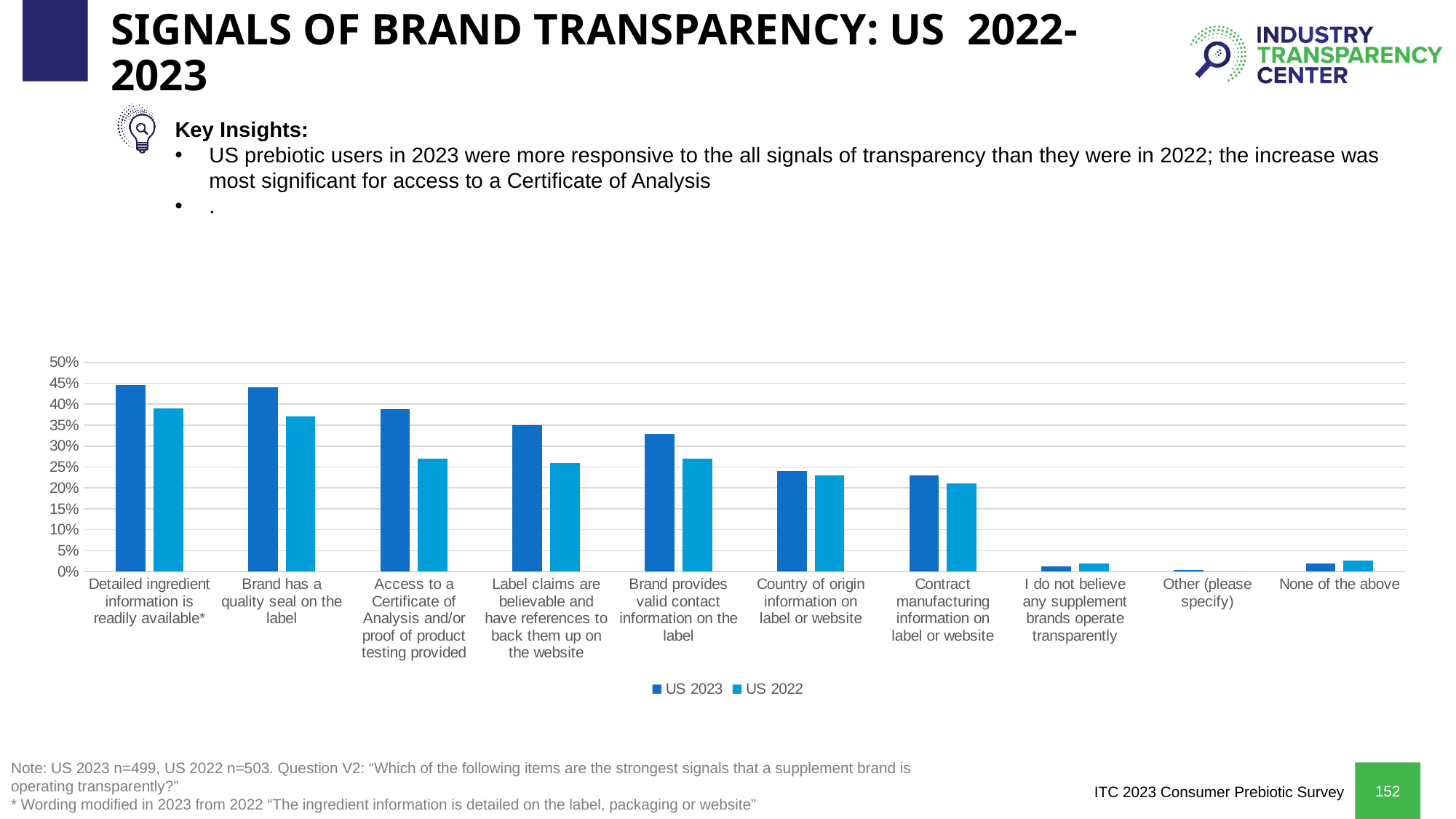
Which category has the lowest US 2023 value? Other (please specify) Which category has the lowest US 2022 value? Other (please specify) For "Label claims are believable and have references to back them up on the website", which series has the larger value, US 2023 or US 2022? US 2023 What is the highest value shown on the chart's vertical axis? 50% Is the US 2023 value for "Access to a Certificate of Analysis and/or proof of product testing provided" greater or less than 35%? greater Is the US 2023 value for "Brand provides valid contact information on the label" greater or less than 30%? greater Is the US 2022 value for "I do not believe any supplement brands operate transparently" greater or less than 5%? less How many series does the chart legend list? 2 What kind of chart is shown on the slide? bar chart Do the US 2023 values generally rise or fall from left to right across the first seven categories? fall How many categories are shown along the x axis of the chart? 10